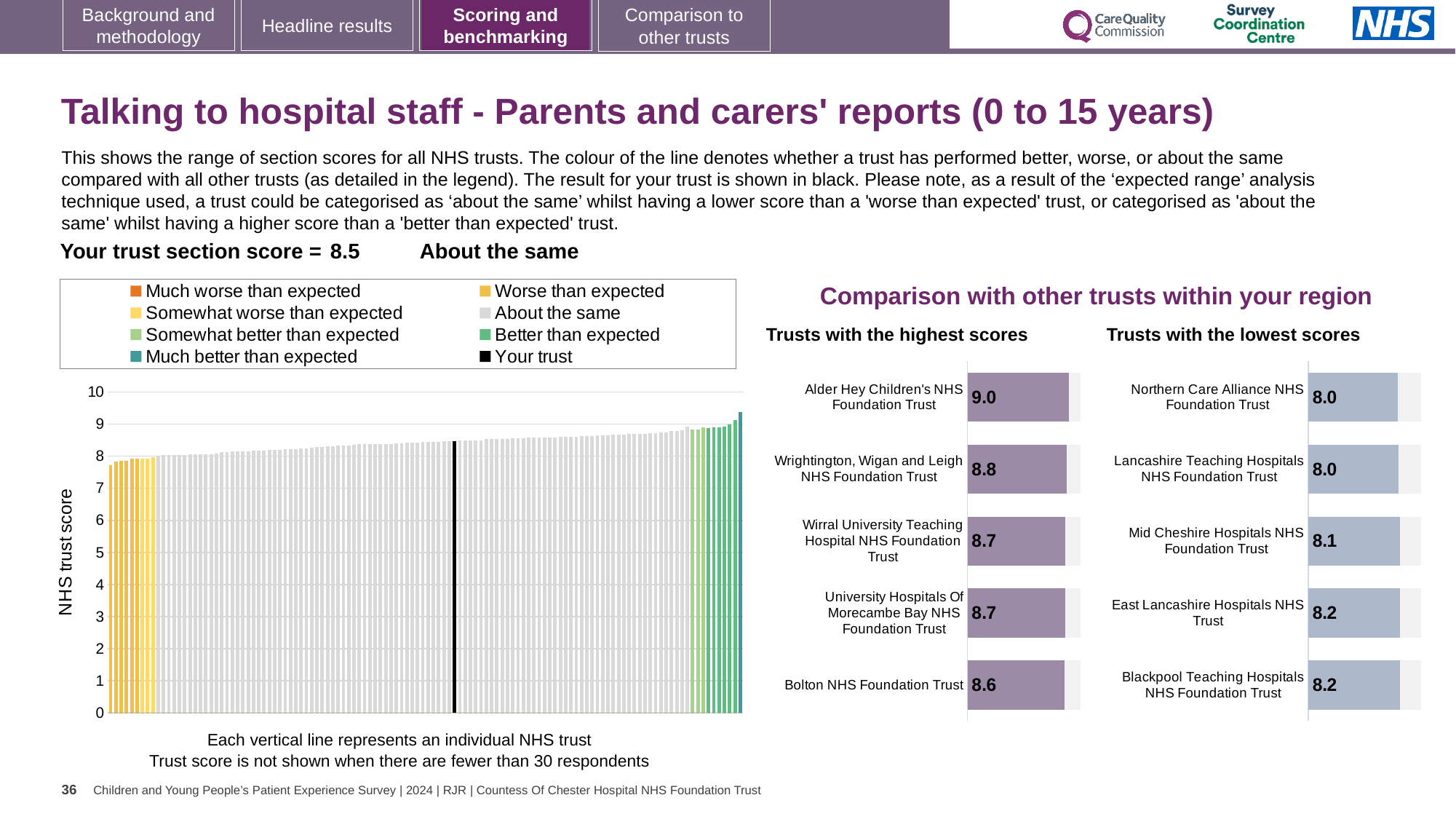
In the 'Trusts with the highest scores' chart, how many trusts are shown? 5 In the 'Trusts with the highest scores' chart, which trust has the highest score? Alder Hey Children's NHS Foundation Trust In the 'Trusts with the highest scores' chart, what is the score for Bolton NHS Foundation Trust? 8.6 What is the y-axis label of the left-hand chart? NHS trust score In the 'Trusts with the lowest scores' chart, what is the score for Blackpool Teaching Hospitals NHS Foundation Trust? 8.2 What kind of chart is the large chart on the left showing NHS trust scores? Bar chart In the 'Trusts with the lowest scores' chart, what is the difference between the scores of East Lancashire Hospitals NHS Trust and Lancashire Teaching Hospitals NHS Foundation Trust? 0.2 How many entries does the legend of the left-hand chart list? 8 In the 'Trusts with the highest scores' chart, what is the difference between the scores of Alder Hey Children's NHS Foundation Trust and Bolton NHS Foundation Trust? 0.4 In the 'Trusts with the highest scores' chart, what is the score for Alder Hey Children's NHS Foundation Trust? 9.0 In the 'Trusts with the lowest scores' chart, which is larger: the score for Mid Cheshire Hospitals NHS Foundation Trust or Northern Care Alliance NHS Foundation Trust? Mid Cheshire Hospitals NHS Foundation Trust In the 'Trusts with the lowest scores' chart, what is the score for Mid Cheshire Hospitals NHS Foundation Trust? 8.1